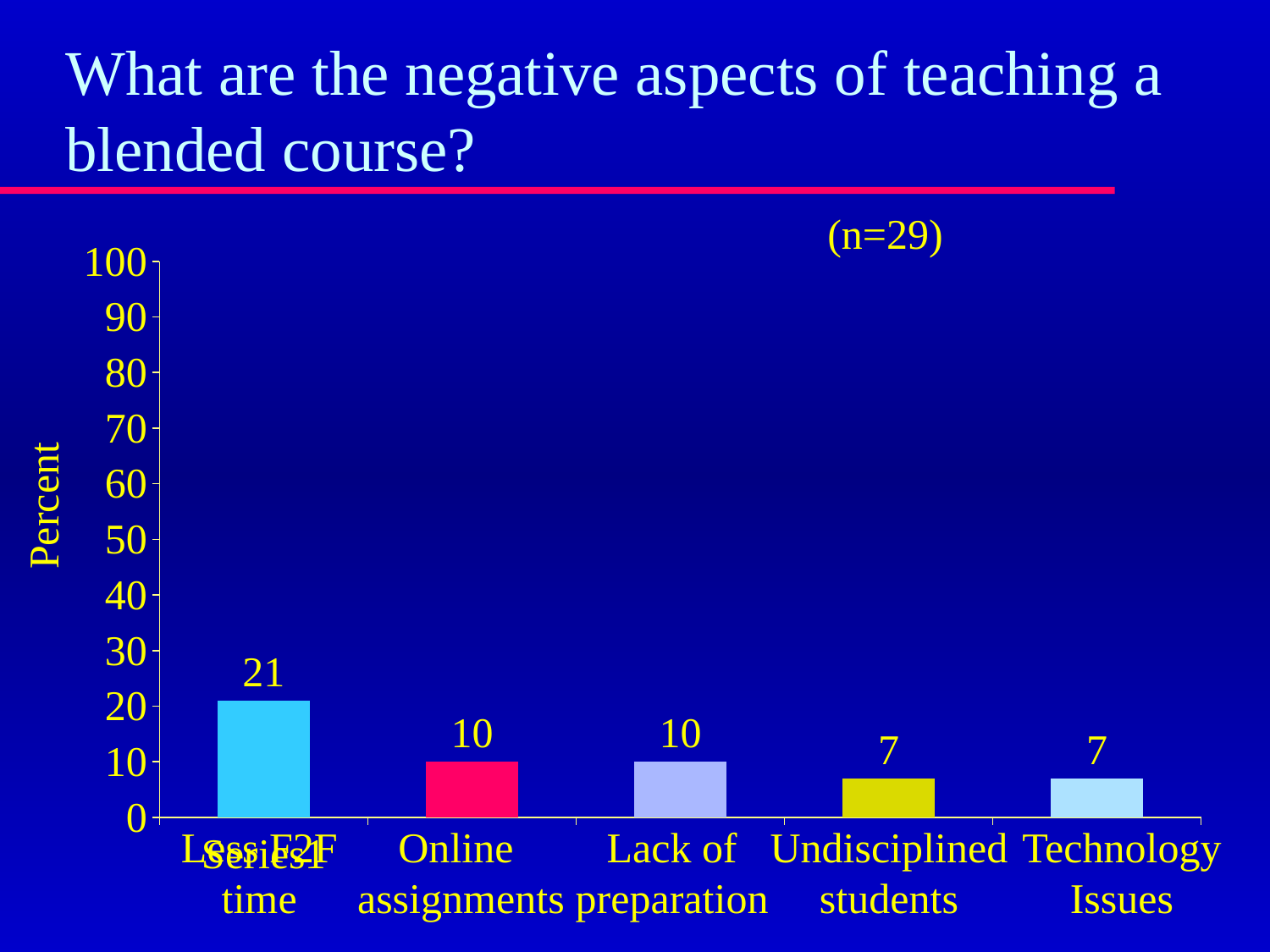
What is the difference between the values for Less F2F time and Lack of preparation? 11 What is the label of the y axis? Percent Is the value for Less F2F time greater or less than 30? less Which category has the highest value? Less F2F time What sample size is shown on the slide? n=29 Which is larger, the value for Online assignments or the value for Undisciplined students? Online assignments What is the value for Online assignments? 10 What is the value for Less F2F time? 21 How many categories are shown on the x axis? 5 What is the value for Technology Issues? 7 What is the value for Undisciplined students? 7 What kind of chart is shown on the slide? bar chart